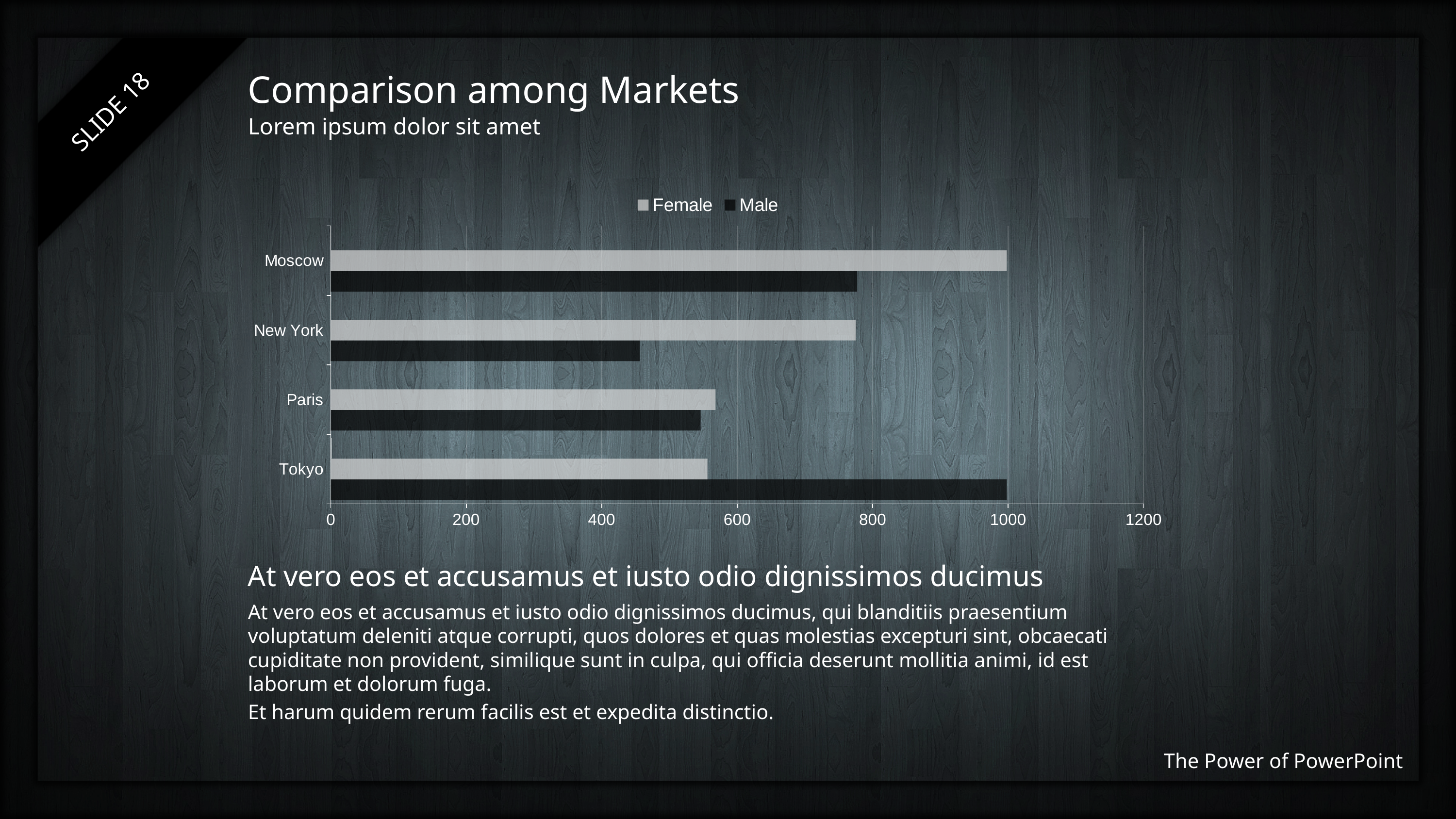
Is the Female value for Paris greater or less than 400? greater For Tokyo, which is larger, the Female value or the Male value? Male For Moscow, which is larger, the Female value or the Male value? Female Which market has the highest Female value? Moscow How many markets (categories) are shown on the chart? 4 What kind of chart is shown on the slide? Bar chart Which market has the lowest Male value? New York Is the Male value for New York greater or less than 600? less How many series does the chart legend list? 2 Which market has the highest Male value? Tokyo What is the title of the chart slide? Comparison among Markets Is the Male value for Moscow greater or less than 600? greater